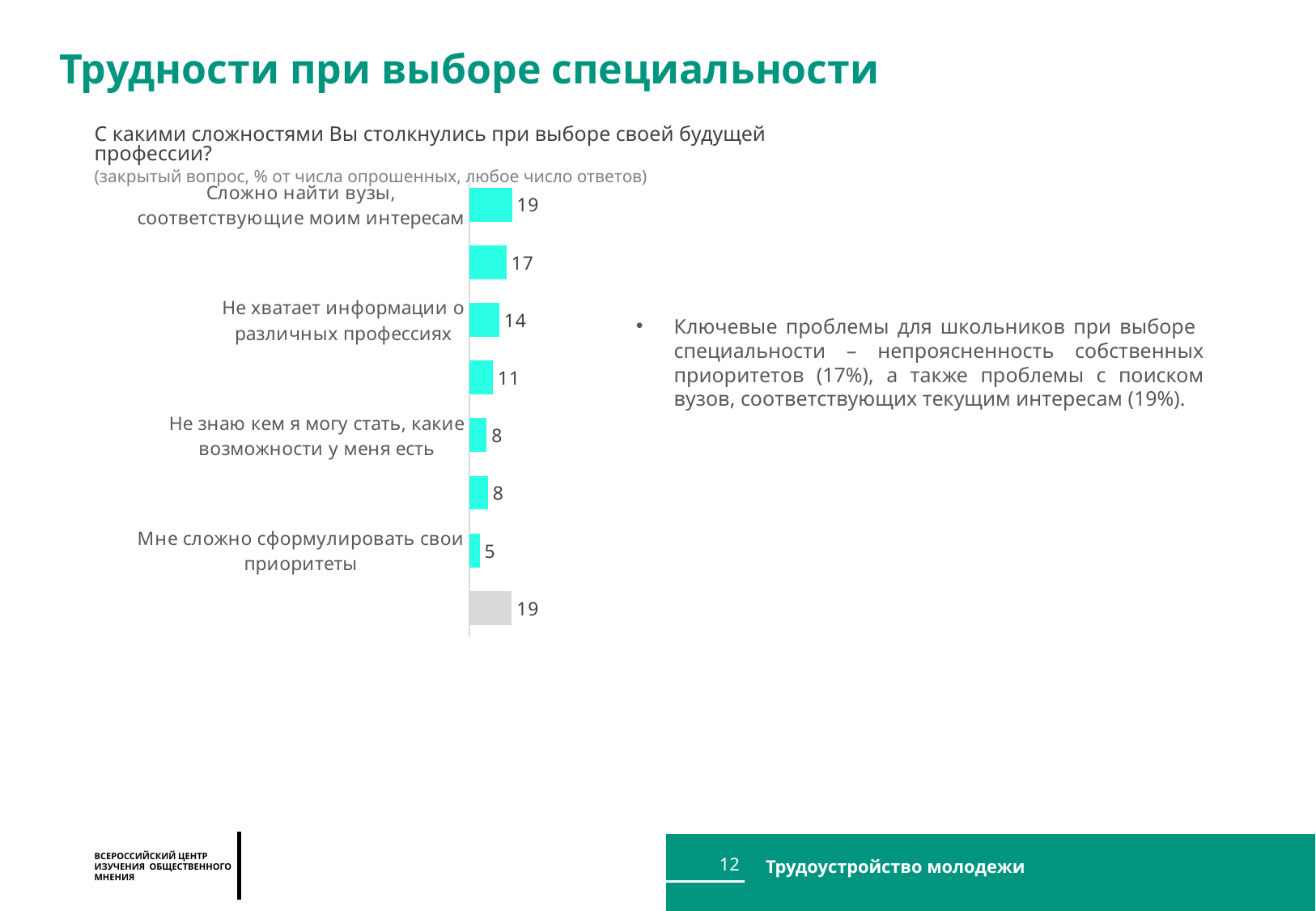
How many bars are plotted in the chart? 8 What is the smallest value shown in the chart? 5 What kind of chart is shown on the slide? bar chart Which is larger: the value for "Сложно найти вузы, соответствующие моим интересам" or for "Не хватает информации о различных профессиях"? Сложно найти вузы, соответствующие моим интересам What colour is the bottom bar of the chart? grey What is the difference between the value for "Сложно найти вузы, соответствующие моим интересам" and the smallest value in the chart? 14 What is the value for "Не хватает информации о различных профессиях"? 14 What is the value of the grey bar at the bottom of the chart? 19 What is the title of the slide containing the chart? Трудности при выборе специальности What is the value for "Сложно найти вузы, соответствующие моим интересам"? 19 What is the value of the second bar from the top? 17 How many bars have the value 8? 2